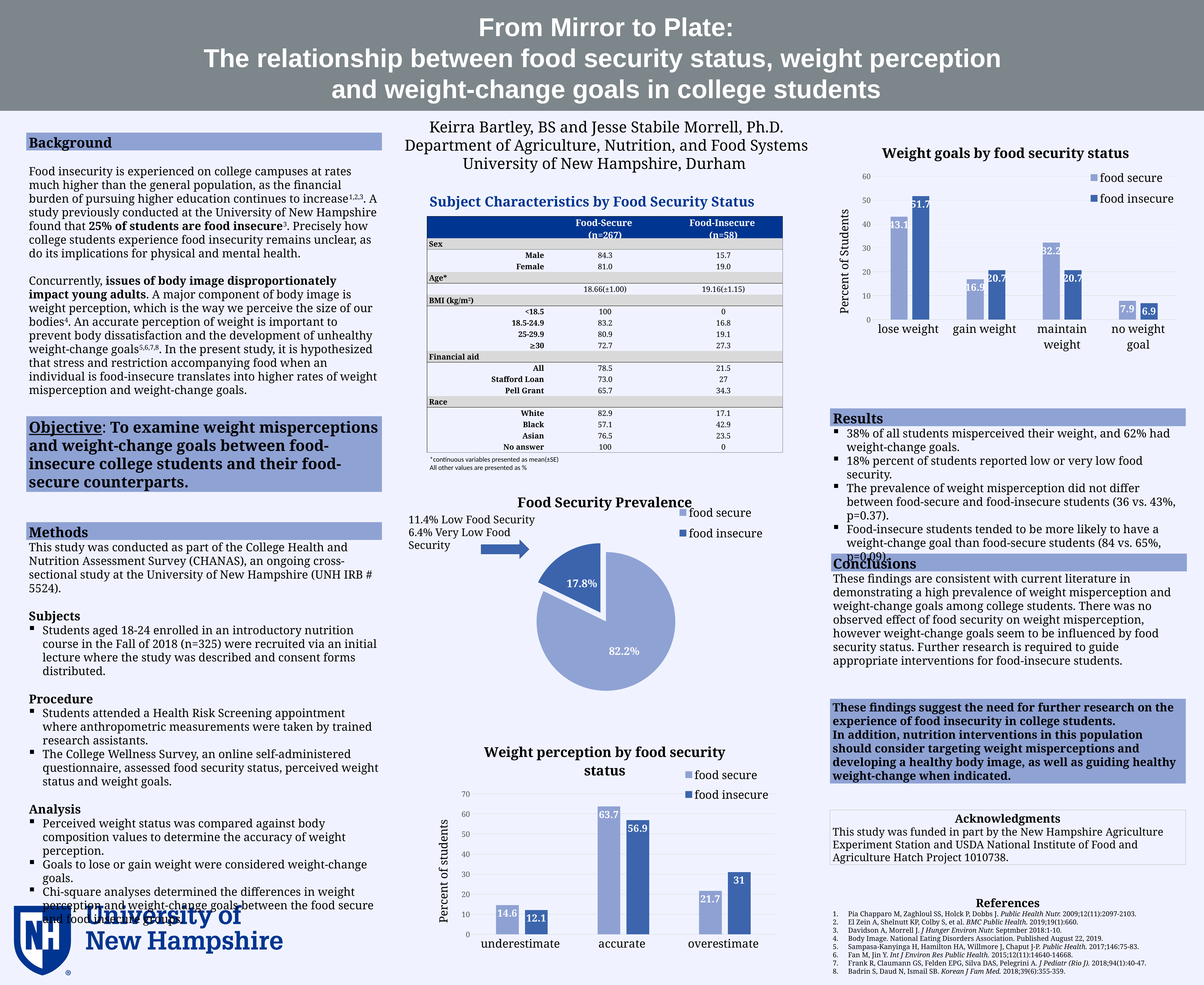
What kind of chart is 'Food Security Prevalence'? pie chart In the 'Weight goals by food security status' chart, what is the value for food secure students who want to maintain weight? 32.2 In the 'Weight perception by food security status' chart, what is the difference between food secure and food insecure students in the 'accurate' category? 6.8 In the 'Food Security Prevalence' pie chart, which slice is larger, food secure or food insecure? food secure In the 'Weight goals by food security status' chart, what is the value for food insecure students who want to lose weight? 51.7 In the 'Weight goals by food security status' chart, how many weight goal categories are shown on the x axis? 4 How many series does the legend of the 'Weight perception by food security status' chart list? 2 In the 'Food Security Prevalence' pie chart, what share of the pie is food insecure? 17.8% In the 'Weight perception by food security status' chart, which category has the highest value for food secure students? accurate In the 'Weight perception by food security status' chart, what is the value for food insecure students who overestimate their weight? 31 In the 'Weight goals by food security status' chart, which weight goal category has the lowest value for food secure students? no weight goal In the 'Weight goals by food security status' chart, what is the difference between food secure and food insecure students for 'maintain weight'? 11.5